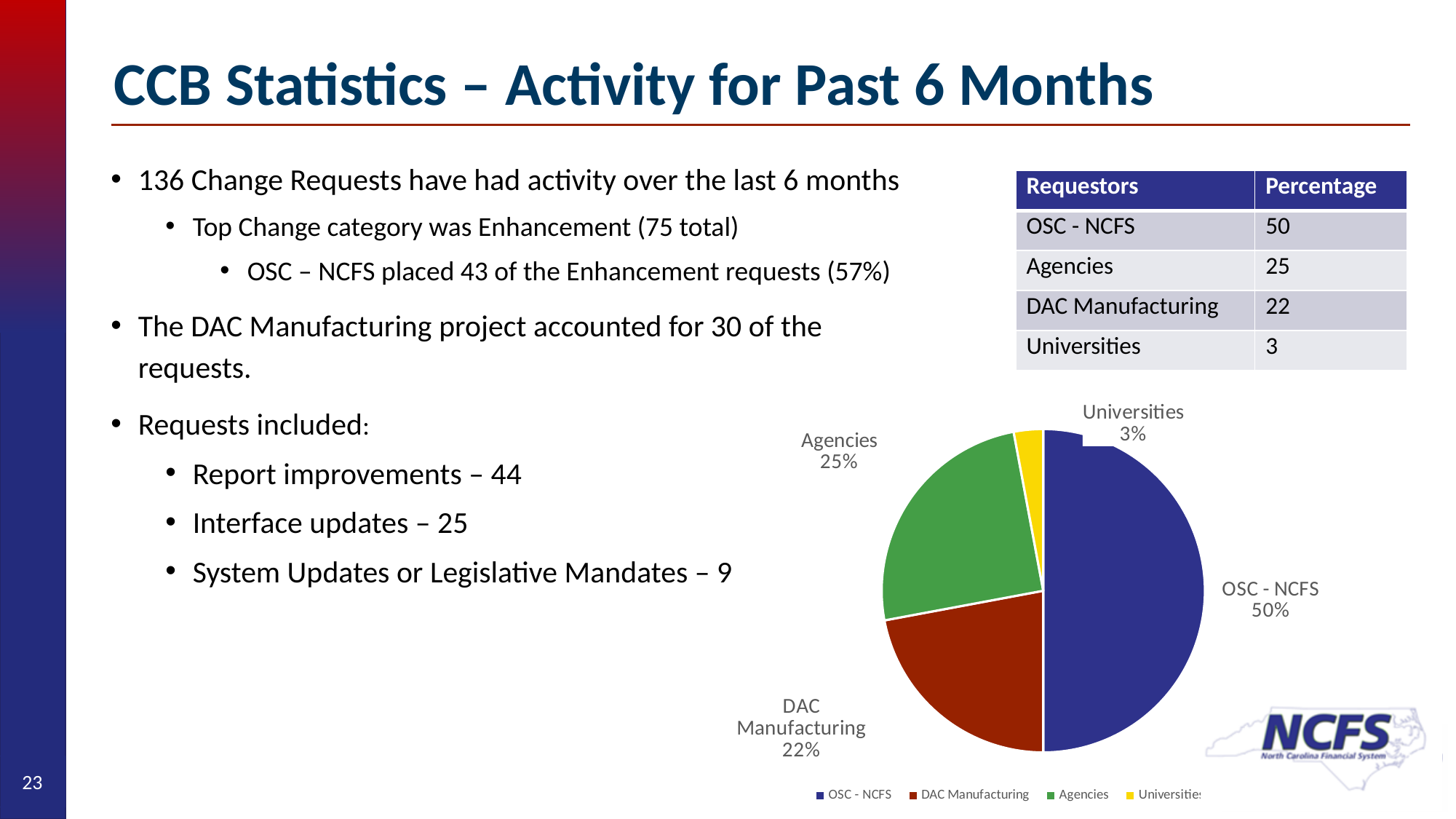
What percentage of the pie chart does OSC - NCFS account for? 50% What percentage of the pie chart does Universities account for? 3% Which requestor has the smallest slice of the pie chart? Universities Which requestor has the largest slice of the pie chart? OSC - NCFS What percentage of the pie chart does Agencies account for? 25% Which slice is larger in the pie chart, Agencies or DAC Manufacturing? Agencies What type of chart is shown on the slide? Pie chart How many slices does the pie chart have? 4 What is the difference in percentage between Agencies and DAC Manufacturing in the pie chart? 3% What is the difference in percentage between OSC - NCFS and Agencies in the pie chart? 25% What colour is the OSC - NCFS slice in the pie chart? Blue What percentage of the pie chart does DAC Manufacturing account for? 22%